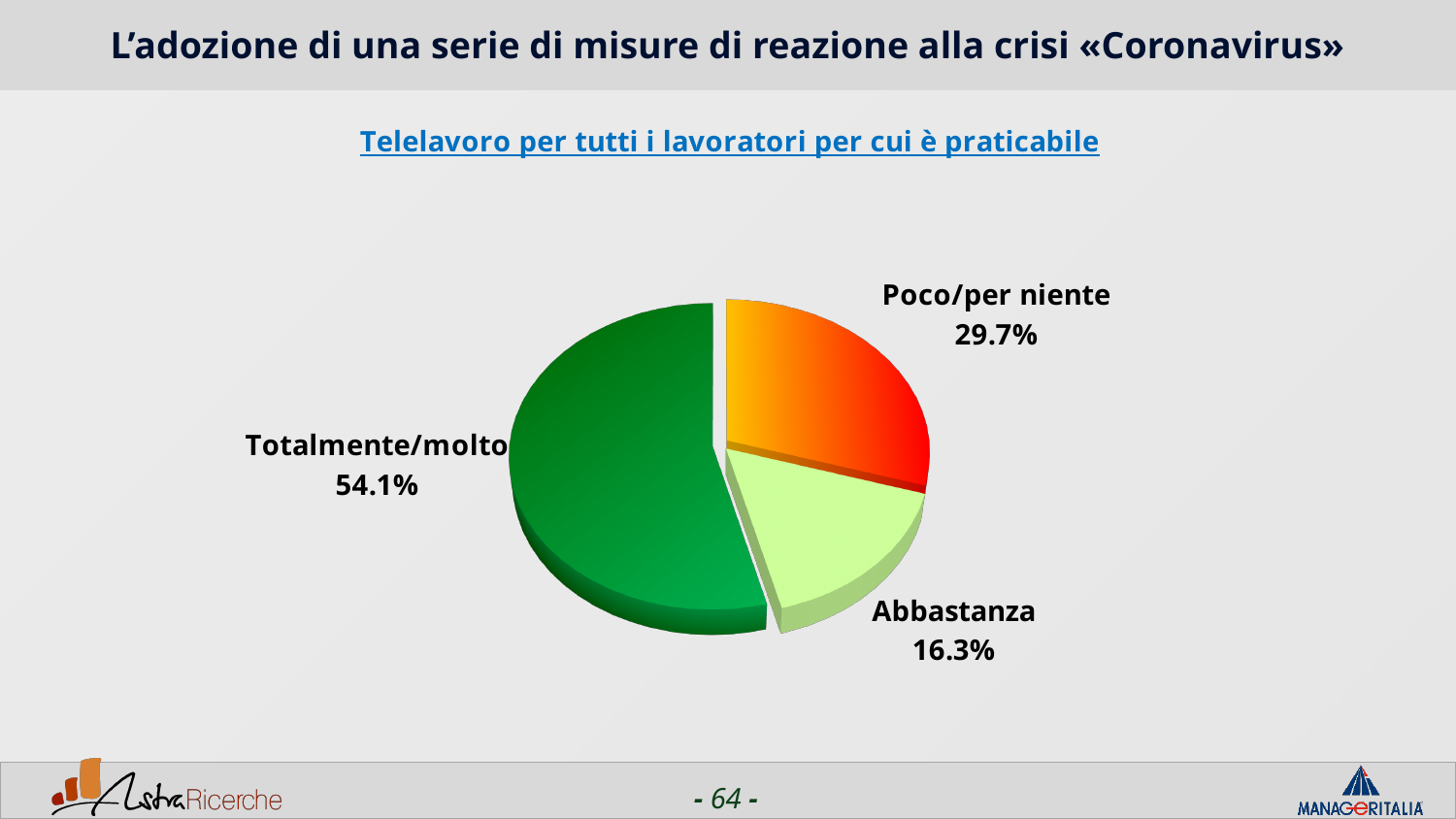
How many slices does the pie chart have? 3 What is the value for Poco/per niente? 29.7% What kind of chart is shown on the slide? Pie chart Which is larger, the value for Poco/per niente or the value for Abbastanza? Poco/per niente What is the title of the chart? Telelavoro per tutti i lavoratori per cui è praticabile What is the difference between the values for Totalmente/molto and Poco/per niente? 24.4% What is the difference between the values for Poco/per niente and Abbastanza? 13.4% Which category has the largest share of the pie? Totalmente/molto What is the value for Abbastanza? 16.3% What is the value for Totalmente/molto? 54.1% Which category has the smallest share of the pie? Abbastanza What colour is the Totalmente/molto slice? Green